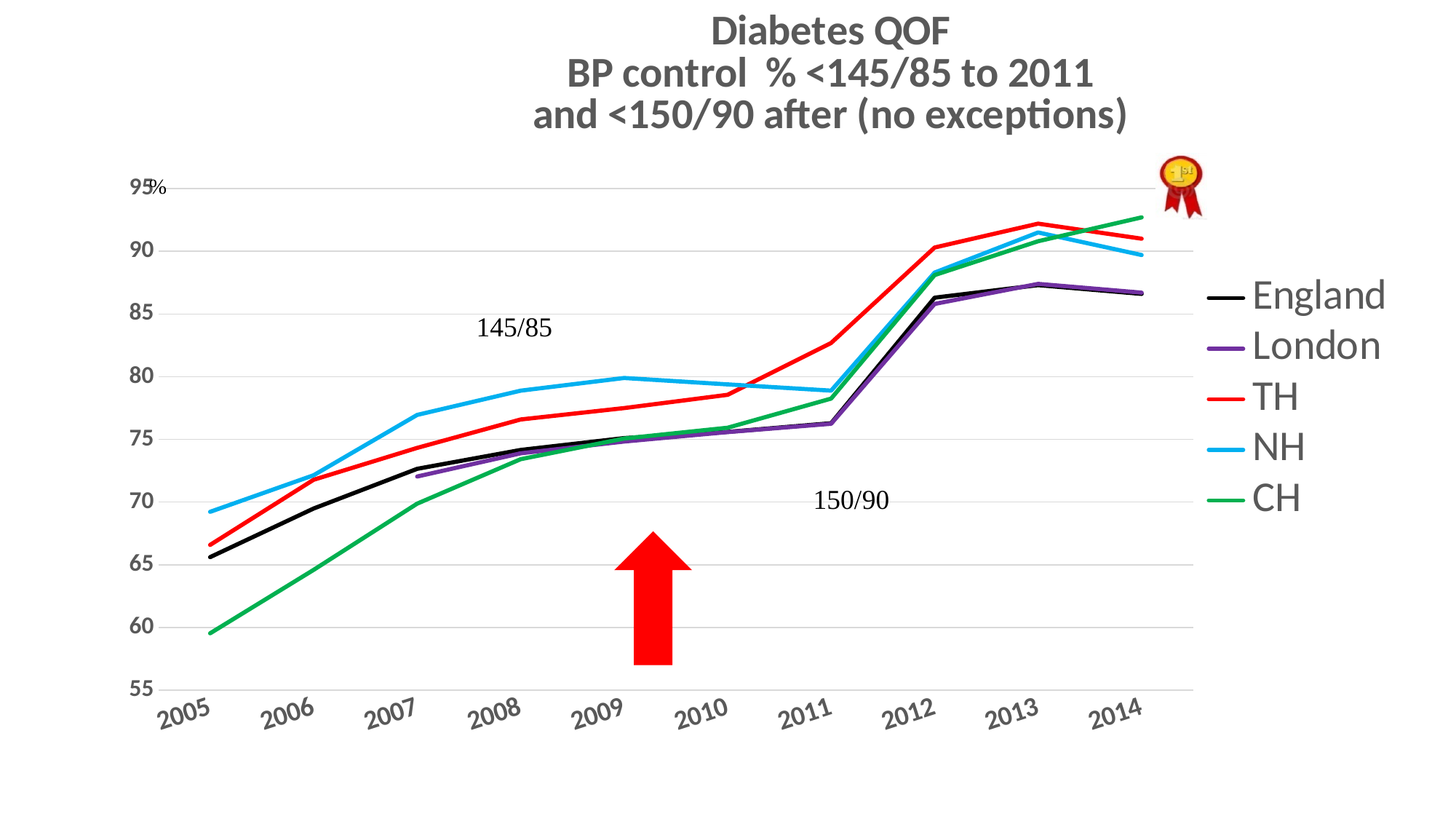
What colour is the line for TH in the legend? red Does the CH line generally rise or fall from 2005 to 2014? rise Which series has the highest value in 2005? NH Which series has the highest value in 2014? CH How many series does the legend list? 5 What kind of chart is shown on the slide? line chart Is the value for TH in 2013 greater or less than 90? greater In 2011, which is larger, the value for TH or the value for NH? TH Is the value for CH in 2005 greater or less than 65? less Which series has the lowest value in 2005? CH Is the value for London in 2013 greater or less than 85? greater How many years are shown along the x axis? 10